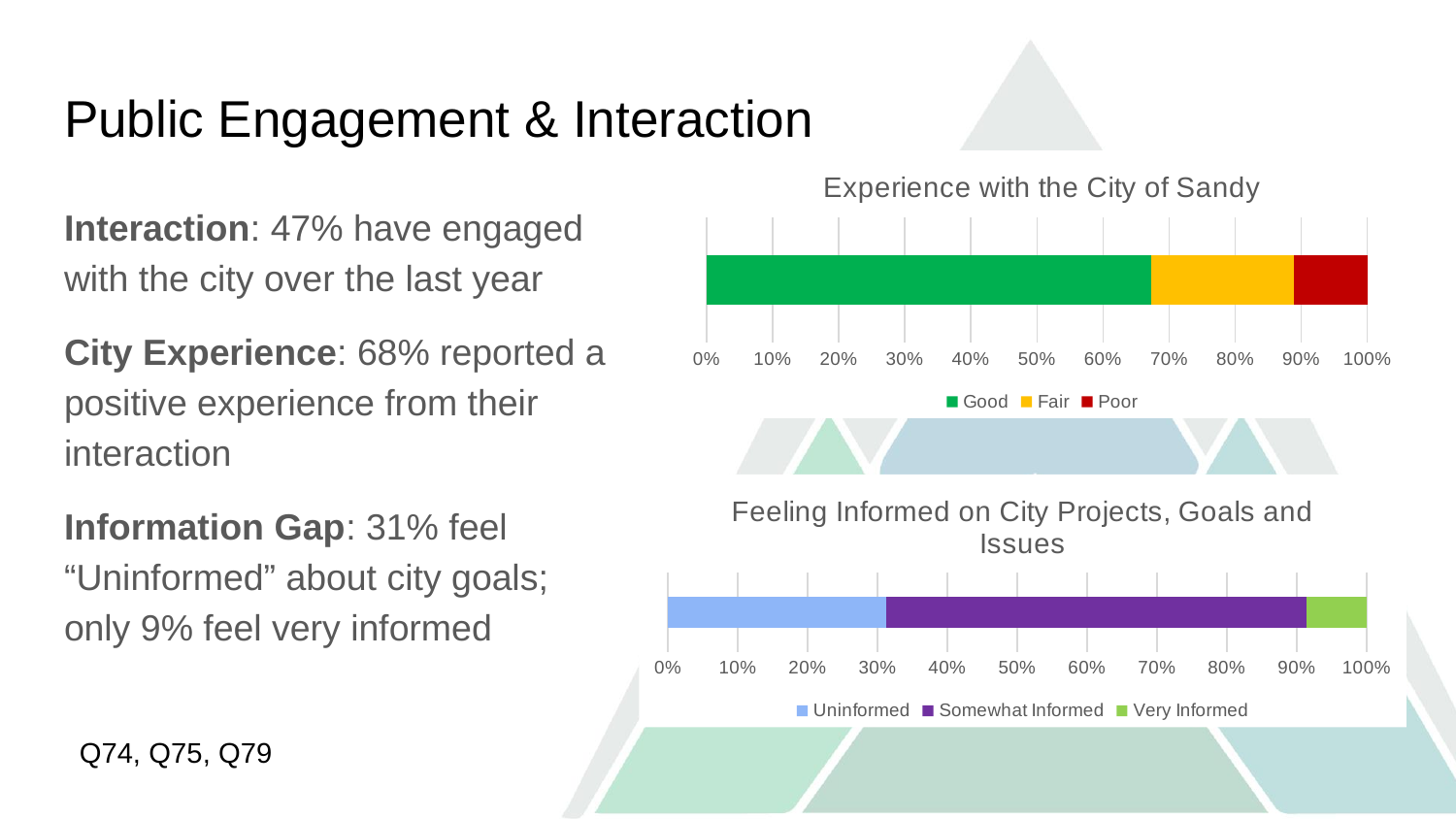
In the "Experience with the City of Sandy" chart, which segment is the smallest? Poor In the "Feeling Informed on City Projects, Goals and Issues" chart, how many series does the legend list? 3 In the "Feeling Informed on City Projects, Goals and Issues" chart, is the value for Uninformed greater or less than 40%? less In the "Experience with the City of Sandy" chart, which segment is the largest? Good In the "Experience with the City of Sandy" chart, is the value for Poor greater or less than 20%? less In the "Experience with the City of Sandy" chart, which is larger, Fair or Poor? Fair In the "Experience with the City of Sandy" chart, what colour represents Good? green In the "Experience with the City of Sandy" chart, how many series does the legend list? 3 In the "Experience with the City of Sandy" chart, is the value for Good greater or less than 60%? greater In the "Feeling Informed on City Projects, Goals and Issues" chart, which segment is the smallest? Very Informed In the "Feeling Informed on City Projects, Goals and Issues" chart, which segment is the largest? Somewhat Informed What kind of chart is the "Experience with the City of Sandy" chart? bar chart